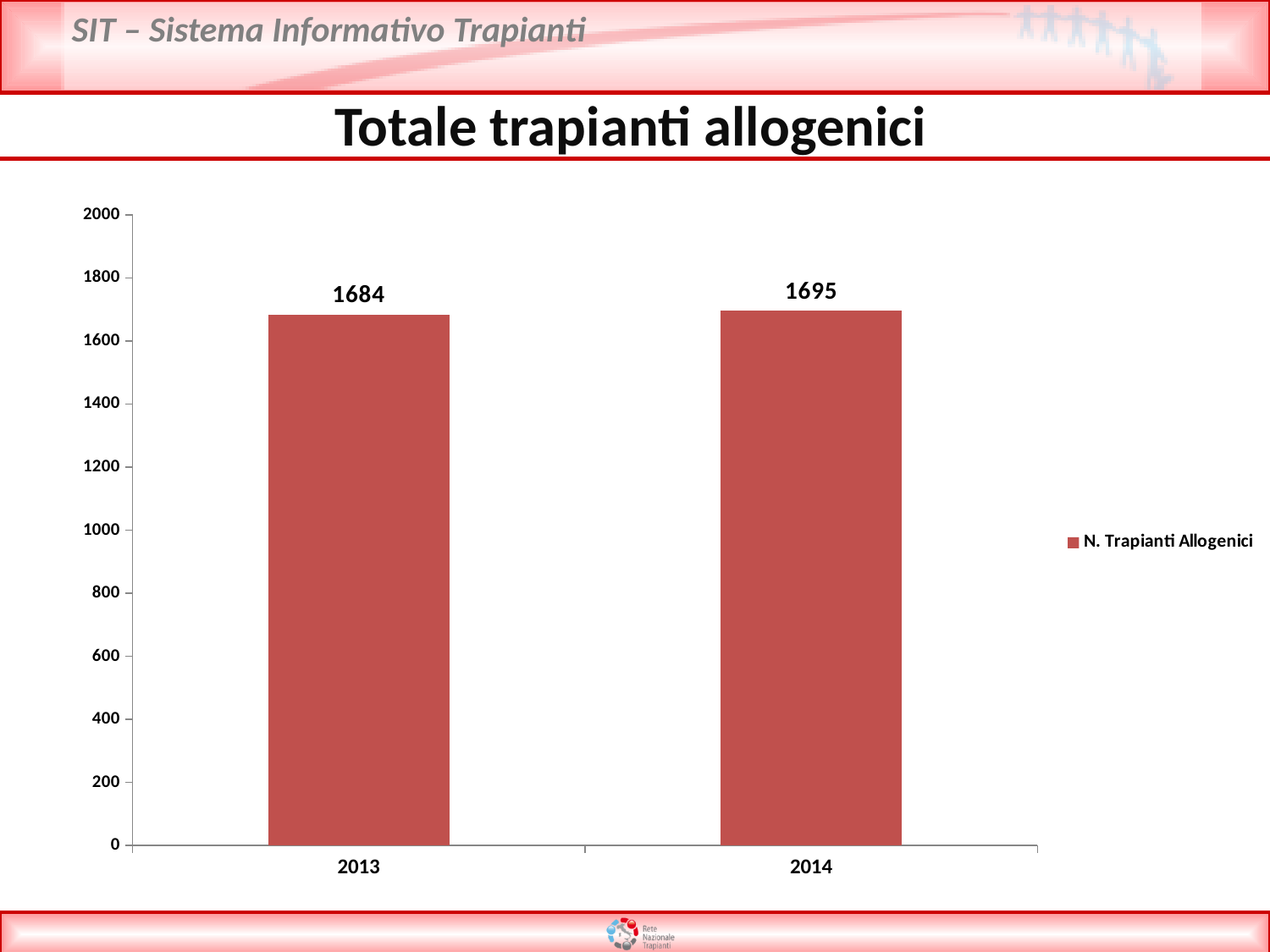
What is the difference between the values for 2014 and 2013? 11 Is the value for 2013 greater or less than 1800? less What is the value for 2013? 1684 How many years are shown on the x axis? 2 What is the value for 2014? 1695 Do the values rise or fall from 2013 to 2014? rise Which year has the lower value? 2013 What kind of chart is shown? bar chart Is the value for 2014 greater or less than 1600? greater Which year has the higher value? 2014 What is the title of the chart? Totale trapianti allogenici How many series does the legend list? 1